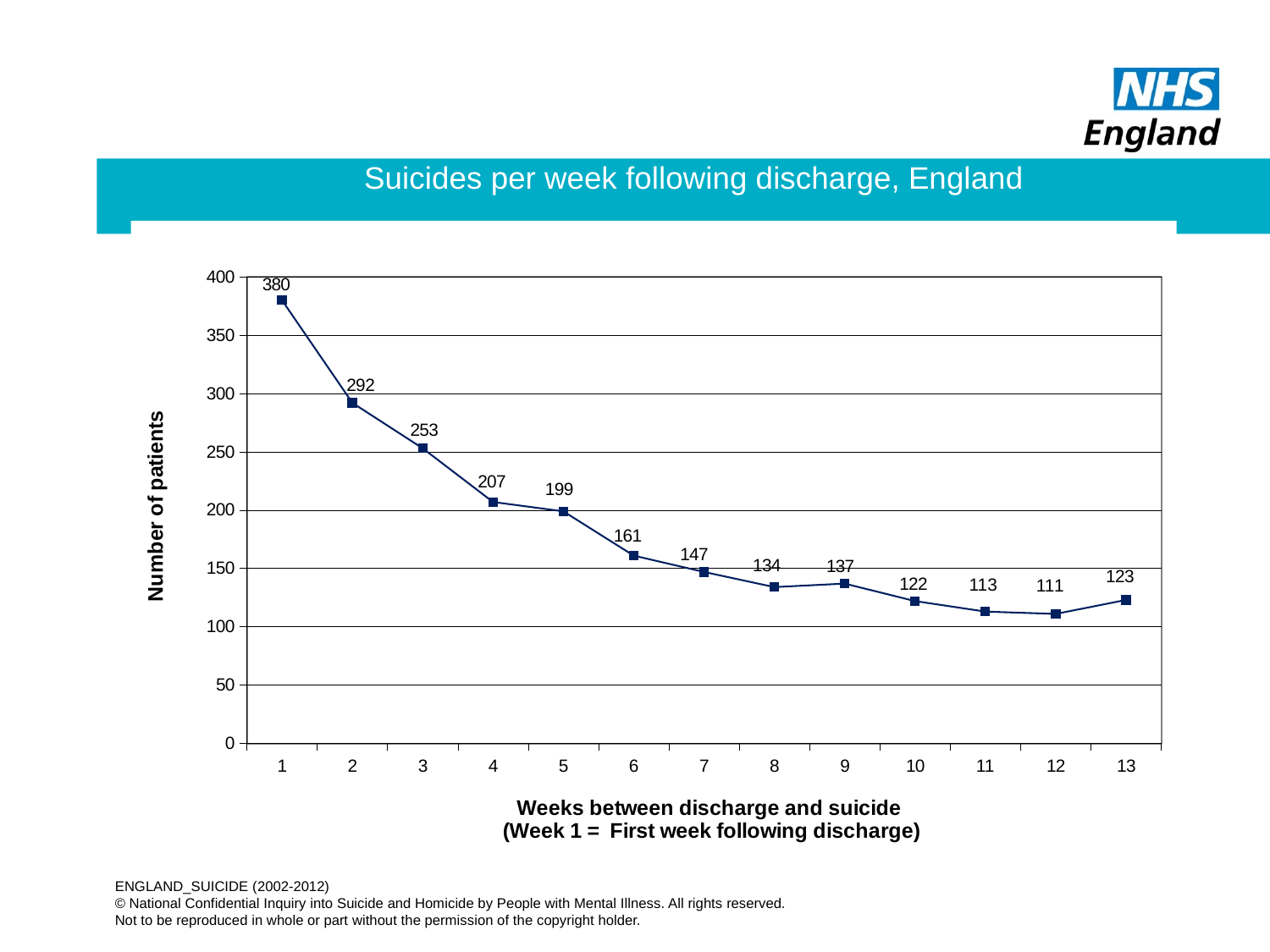
What is the number of patients for week 1? 380 Which has more patients, week 8 or week 9? week 9 What is the number of patients for week 5? 199 How many weeks are plotted on the x axis? 13 Is the value for week 3 greater or less than 250? greater What is the number of patients for week 13? 123 Do the values generally rise or fall from week 1 to week 12? fall Which week has the lowest number of patients? 12 What kind of chart is shown on the slide? line chart What is the difference in number of patients between week 6 and week 7? 14 What is the difference in number of patients between week 1 and week 2? 88 Which week has the highest number of patients? 1